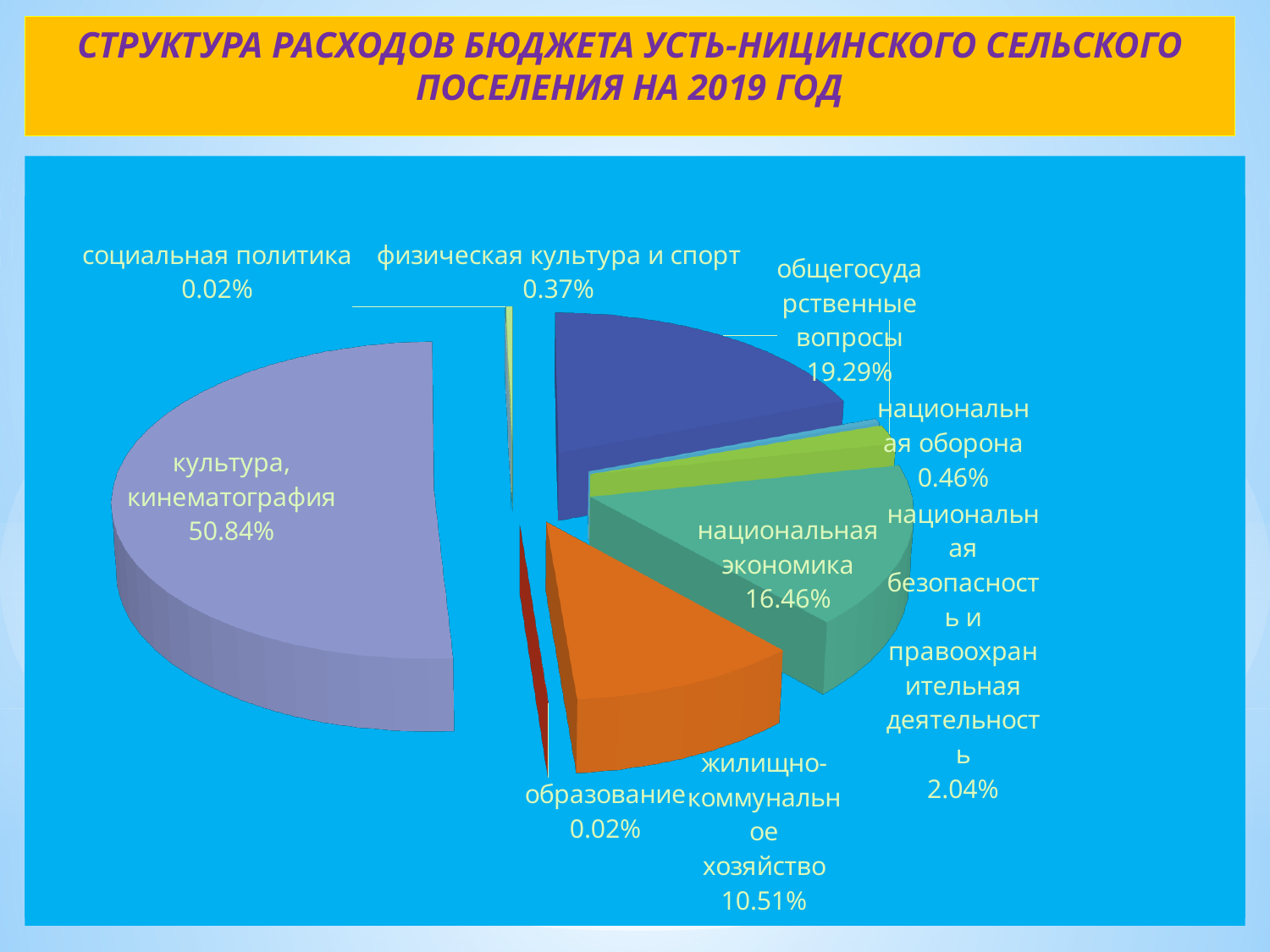
How many categories are shown in the pie chart? 9 Which category has the largest share of the pie? культура, кинематография Which is larger: национальная экономика or жилищно-коммунальное хозяйство? национальная экономика What is the value for жилищно-коммунальное хозяйство? 10.51% What year does the chart title say the budget expenditure structure is for? 2019 What percentage is shown for национальная экономика? 16.46% What type of chart is shown on the slide? Pie chart What is the difference between the shares of культура, кинематография and общегосударственные вопросы? 31.55% What is the value for физическая культура и спорт? 0.37% What percentage is labelled for национальная оборона? 0.46% What is the value shown for общегосударственные вопросы? 19.29% What share of the budget expenditure goes to культура, кинематография? 50.84%